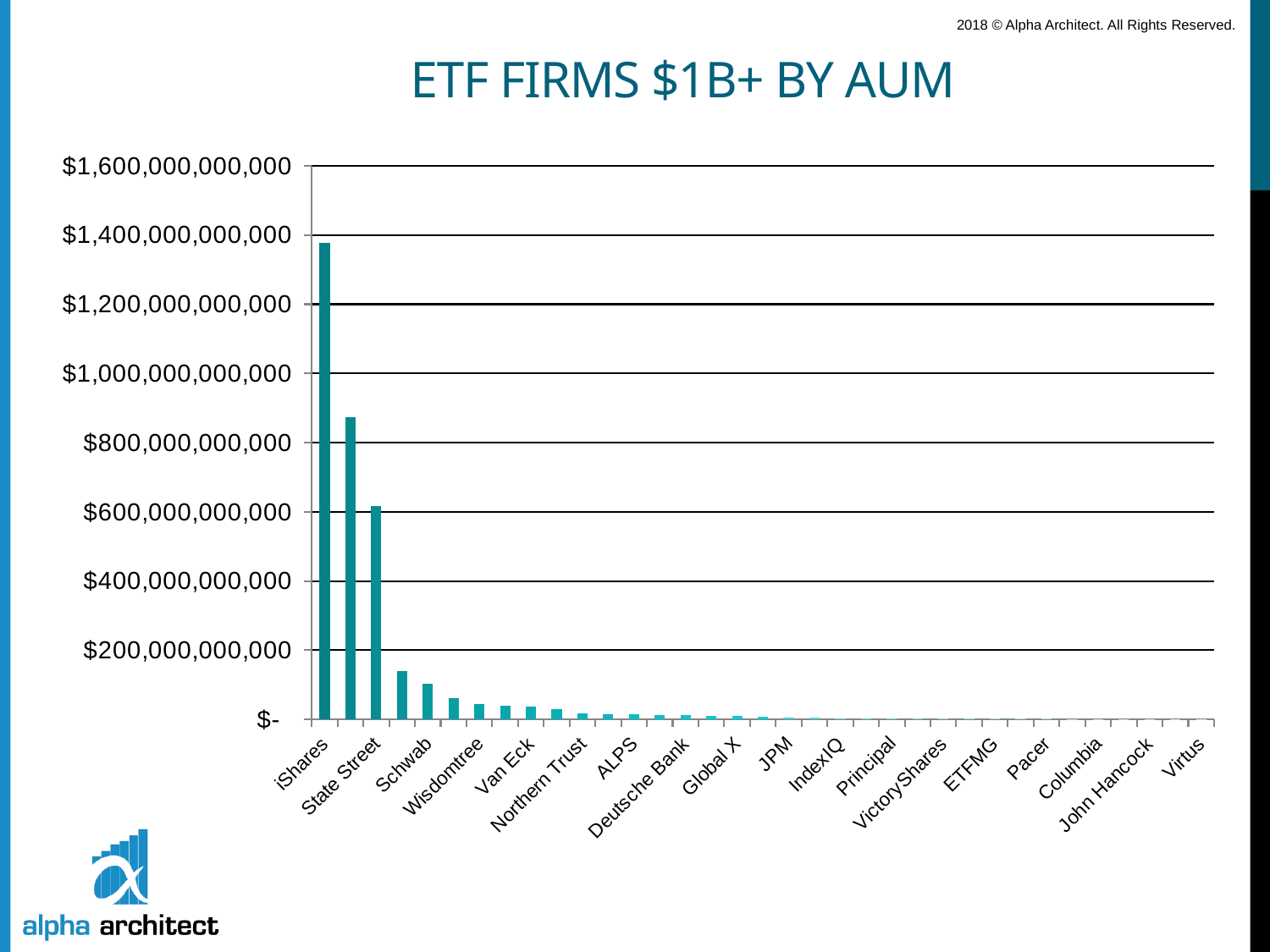
Is the value for State Street greater or less than $400,000,000,000? greater Do the bar values rise or fall moving from left to right along the x axis? fall Which has a larger AUM, State Street or Schwab? State Street What is the title of the chart? ETF FIRMS $1B+ BY AUM What is the highest value shown on the y axis? $1,600,000,000,000 Is the value for State Street greater or less than $1,000,000,000,000? less Which ETF firm has the highest AUM in the chart? iShares Is the value for Schwab greater or less than $200,000,000,000? less Which has a larger AUM, iShares or State Street? iShares What kind of chart is shown on the slide? bar chart